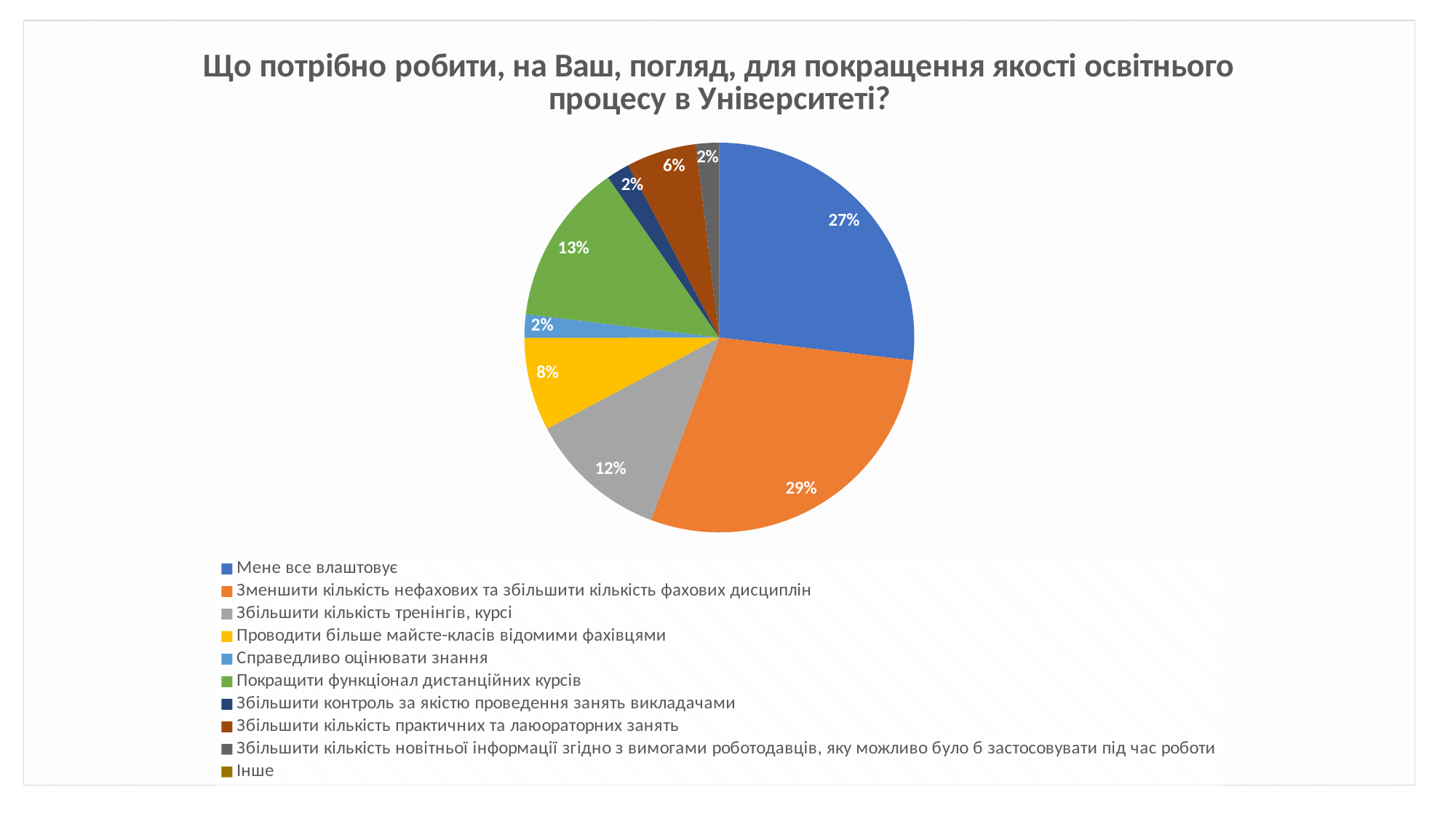
What share of the pie does "Проводити більше майсте-класів відомими фахівцями" have? 8% What share of the pie does "Мене все влаштовує" have? 27% What share of the pie does "Покращити функціонал дистанційних курсів" have? 13% What type of chart is shown on the slide? pie chart Which has a larger share: "Покращити функціонал дистанційних курсів" or "Збільшити кількість тренінгів, курсі"? Покращити функціонал дистанційних курсів What is the difference between the shares of "Зменшити кількість нефахових та збільшити кількість фахових дисциплін" and "Мене все влаштовує"? 2% What share of the pie does "Збільшити кількість практичних та лаюораторних занять" have? 6% Which category has the largest share of the pie? Зменшити кількість нефахових та збільшити кількість фахових дисциплін How many entries does the legend list? 10 What colour is the slice for "Проводити більше майсте-класів відомими фахівцями"? yellow What share of the pie does "Збільшити кількість тренінгів, курсі" have? 12% What share of the pie does "Зменшити кількість нефахових та збільшити кількість фахових дисциплін" have? 29%